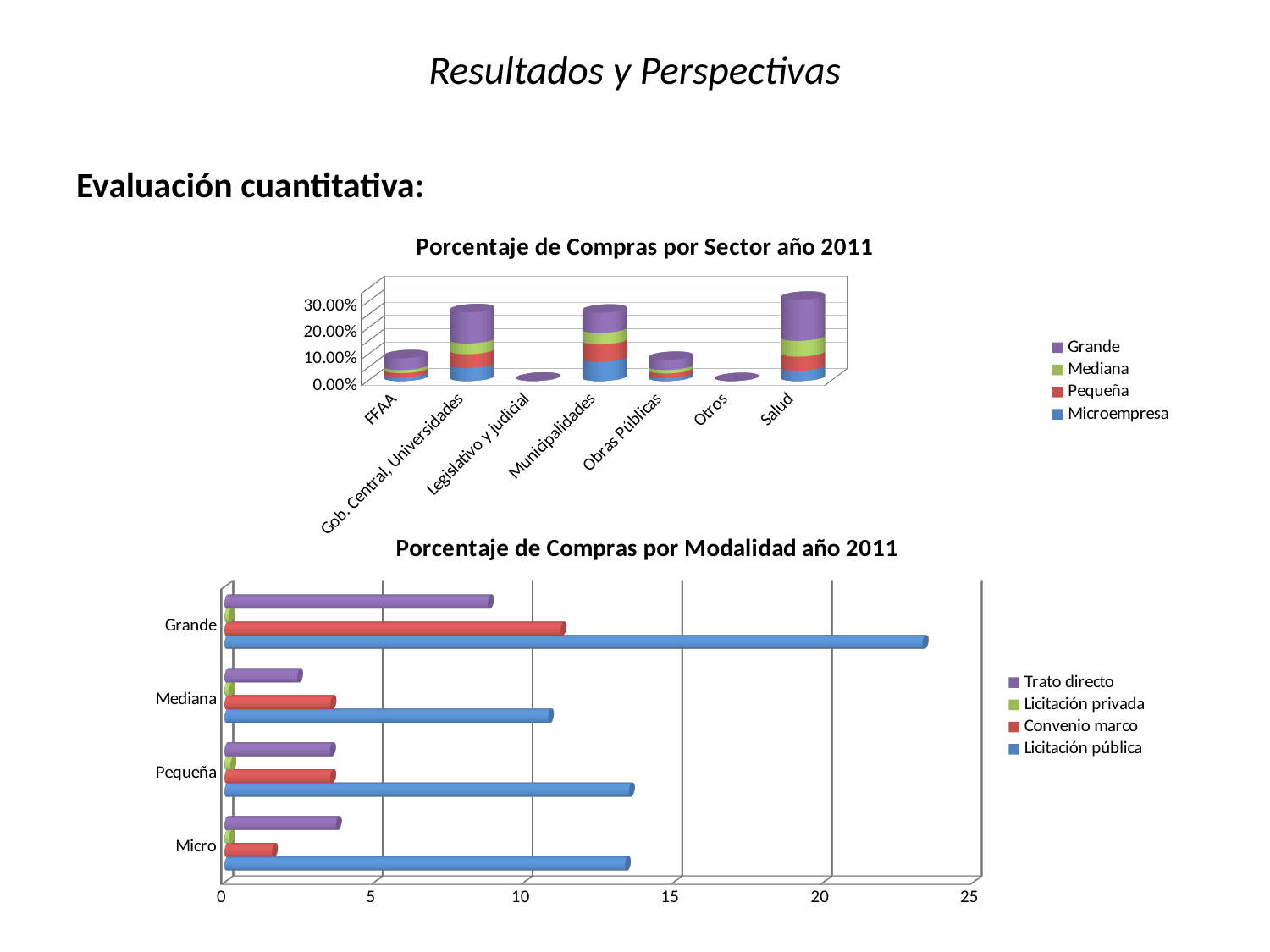
In 'Porcentaje de Compras por Modalidad año 2011', which is larger: the Convenio marco value for Grande or for Mediana? Grande How many categories are shown on the x axis of 'Porcentaje de Compras por Sector año 2011'? 7 How many categories are shown in 'Porcentaje de Compras por Modalidad año 2011'? 4 In 'Porcentaje de Compras por Modalidad año 2011', which category has the longest Licitación pública bar? Grande In 'Porcentaje de Compras por Modalidad año 2011', is the Trato directo value for Grande greater or less than 10? less How many series does the legend of 'Porcentaje de Compras por Sector año 2011' list? 4 What type of chart is 'Porcentaje de Compras por Modalidad año 2011'? bar chart In 'Porcentaje de Compras por Modalidad año 2011', which is larger: the Trato directo value for Grande or for Micro? Grande In 'Porcentaje de Compras por Modalidad año 2011', is the Convenio marco value for Micro greater or less than 5? less In 'Porcentaje de Compras por Modalidad año 2011', is the Licitación pública value for Grande greater or less than 20? greater In 'Porcentaje de Compras por Sector año 2011', which sector has the tallest stacked bar? Salud In 'Porcentaje de Compras por Modalidad año 2011', which series does the legend list first? Trato directo